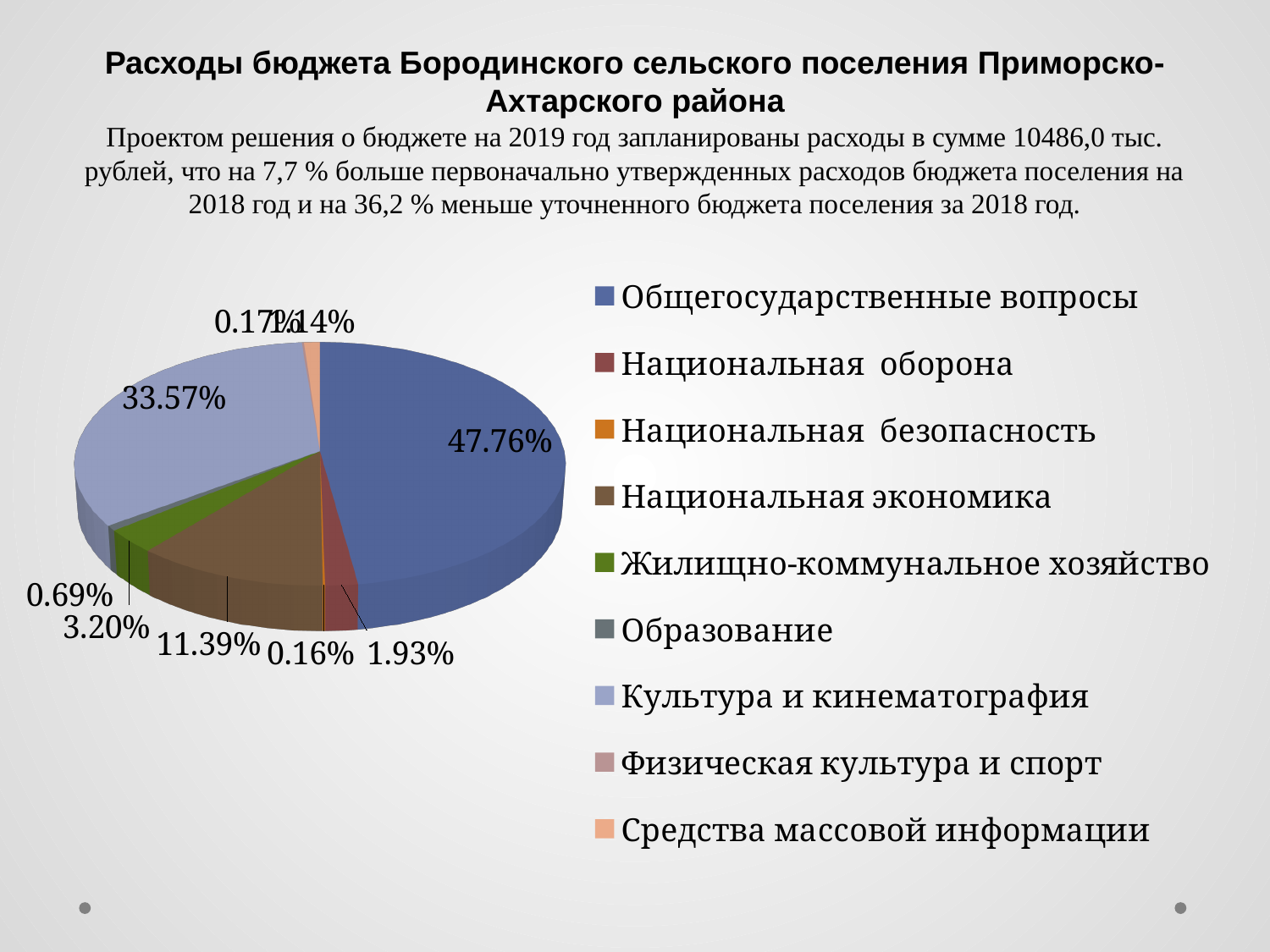
What share is labelled for Национальная экономика? 11.39% What percentage is shown for Культура и кинематография? 33.57% What share is shown for Национальная оборона? 1.93% Which has the larger share: Национальная экономика or Жилищно-коммунальное хозяйство? Национальная экономика Which category has the largest share of the pie? Общегосударственные вопросы What is the difference in percentage points between Общегосударственные вопросы and Культура и кинематография? 14.19% What percentage does the chart show for Жилищно-коммунальное хозяйство? 3.20% What share of the budget expenditures goes to Общегосударственные вопросы? 47.76% How many categories are listed in the chart legend? 9 What type of chart is shown on the slide? Pie chart What percentage is labelled for Образование? 0.69% Which category is represented by the green slice? Жилищно-коммунальное хозяйство